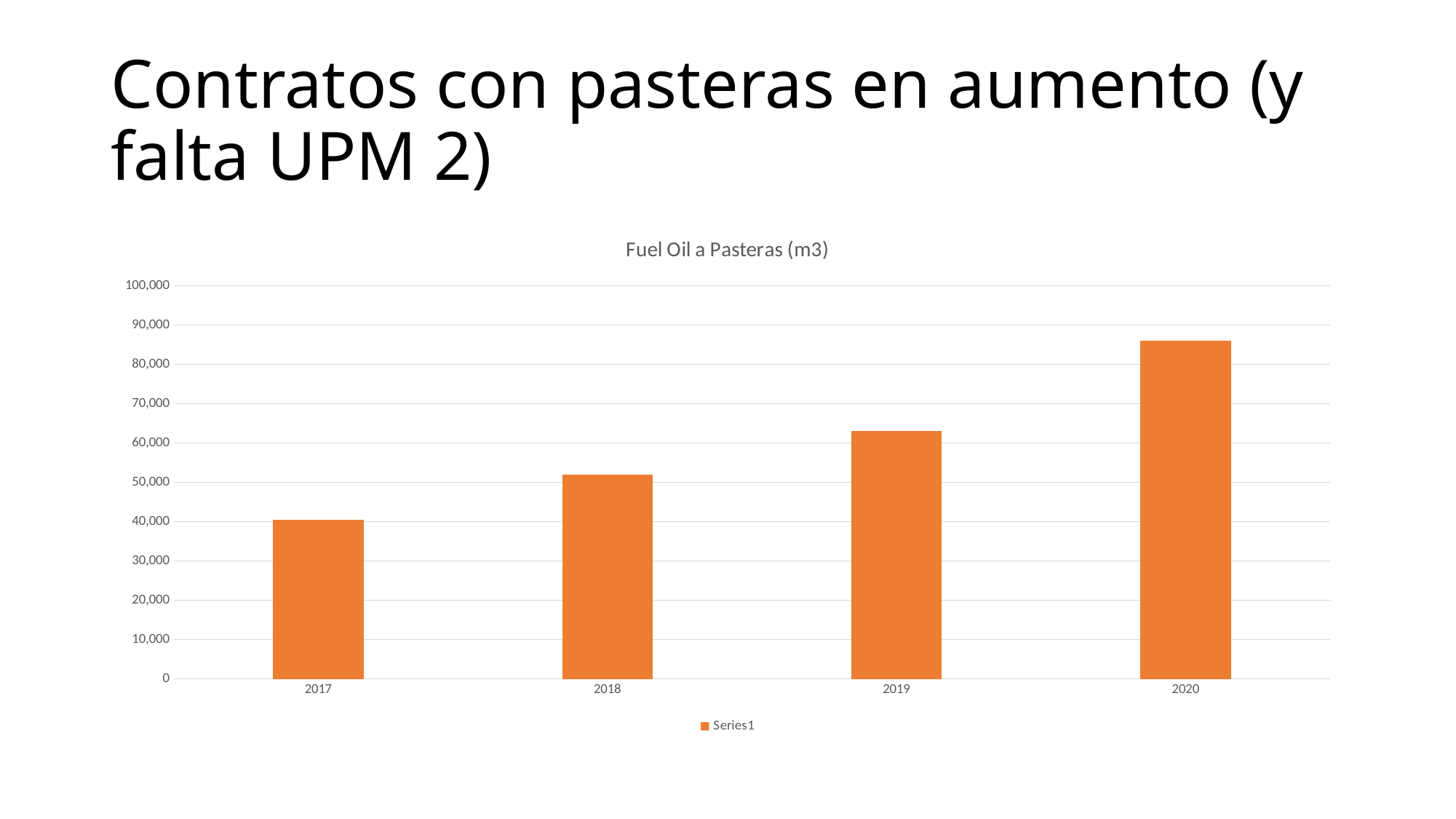
Is the value for 2019 greater or less than 60,000? greater What is the title of the chart? Fuel Oil a Pasteras (m3) Is the value for 2020 greater or less than 90,000? less How many series does the legend list? 1 Which year has the lowest value in the chart? 2017 How many years are shown on the x axis of the chart? 4 Which is larger, the value for 2018 or the value for 2019? 2019 Which year has the highest value in the chart? 2020 What kind of chart is shown on the slide? bar chart Is the value for 2018 greater or less than 50,000? greater Do the values rise or fall from 2017 to 2020? rise